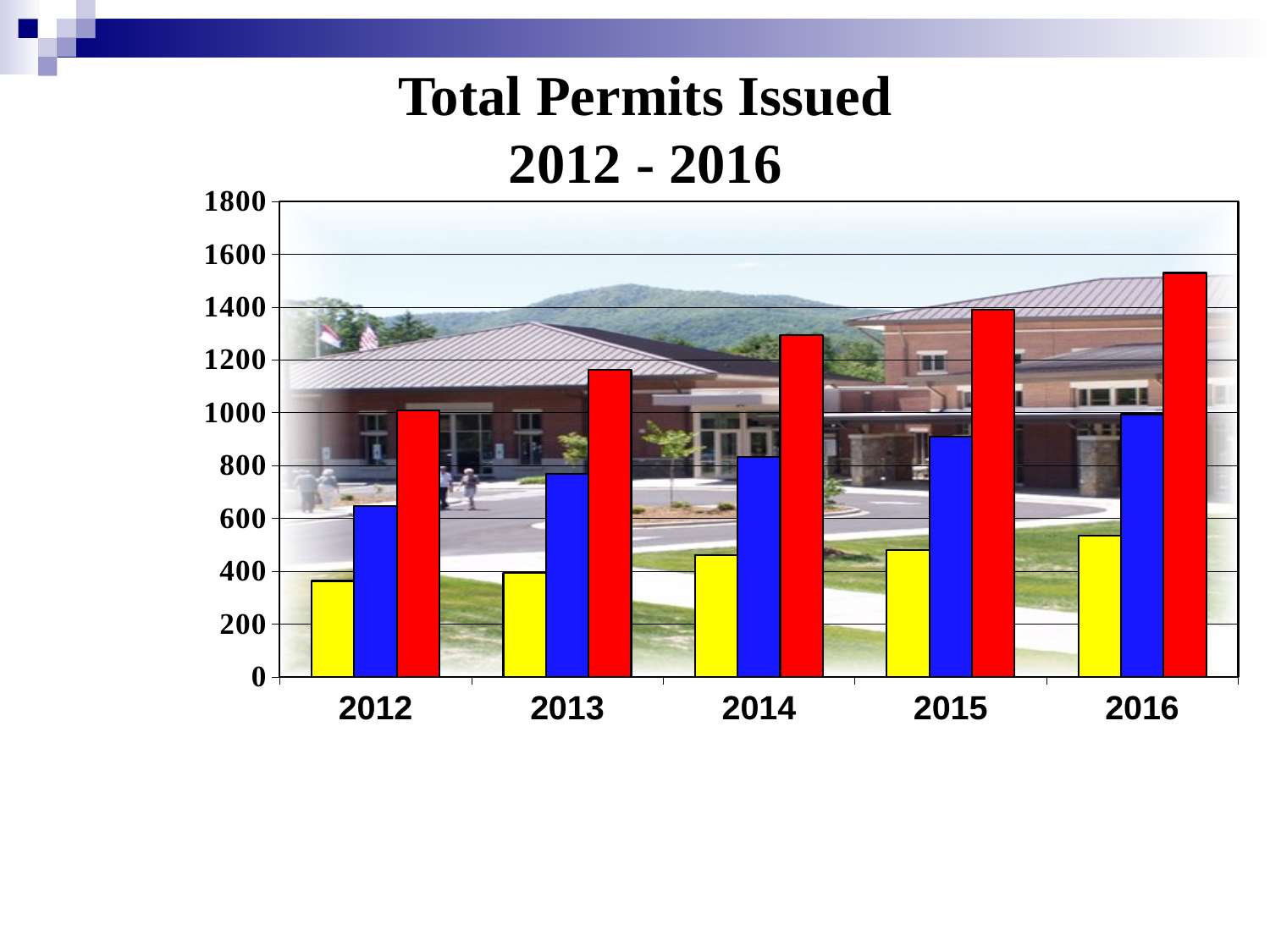
In which year is the yellow bar the shortest? 2012 How many years are shown along the x axis of the chart? 5 Is the value of the red bar for 2014 greater or less than 1200? greater Is the value of the yellow bar for 2012 greater or less than 400? less What is the title of the chart? Total Permits Issued 2012 - 2016 What kind of chart is shown on the slide? bar chart Is the value of the yellow bar for 2016 greater or less than 400? greater How many bars are shown for each year in the chart? 3 Do the red bars rise or fall from 2012 to 2016? rise In which year is the red bar the tallest? 2016